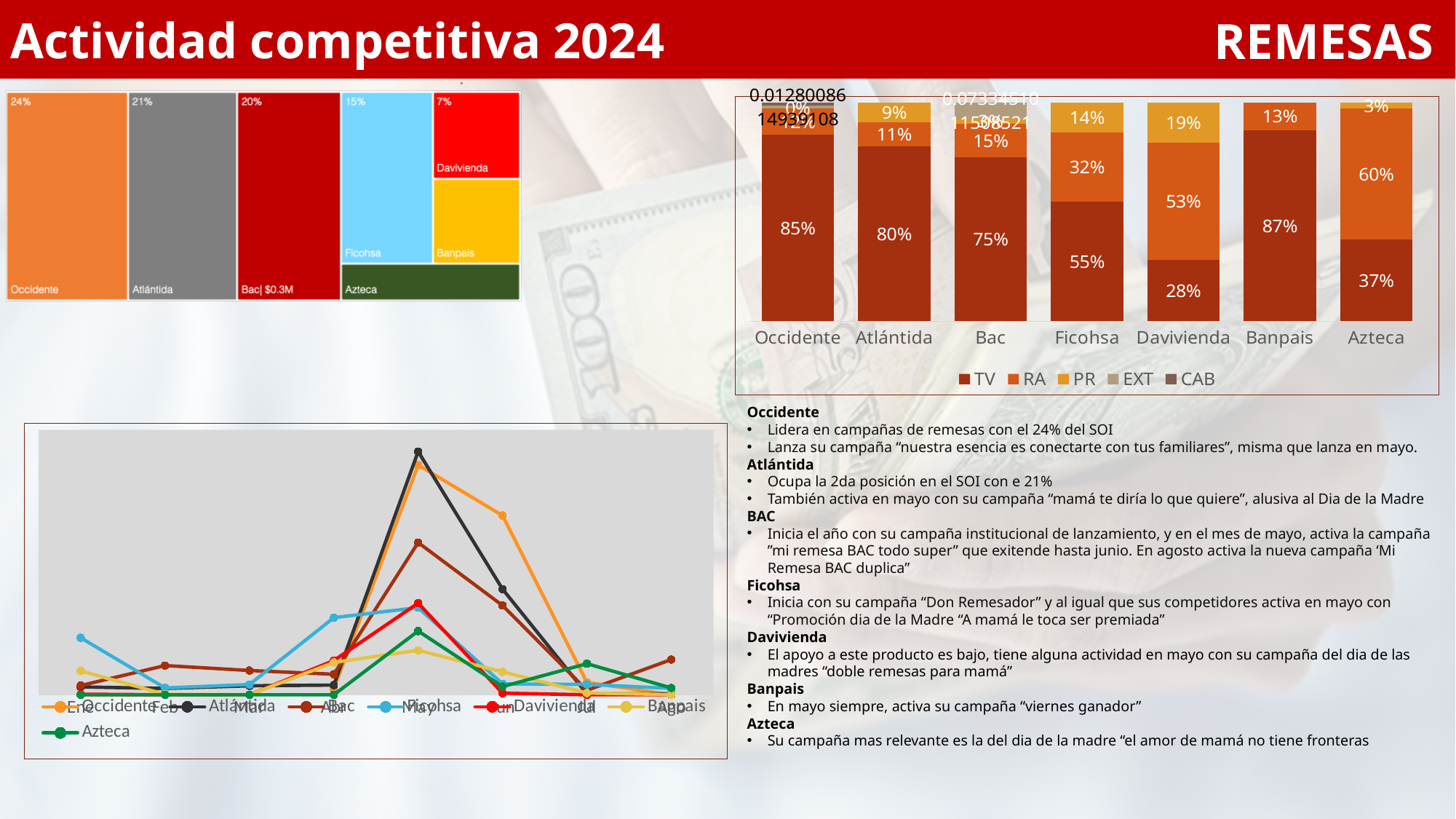
In the treemap chart at the top left, which company has the largest share? Occidente In the stacked bar chart at the top right, how many companies are shown on the x axis? 7 What kind of chart is shown at the bottom left of the slide? Line chart In the stacked bar chart at the top right, is the TV value for Ficohsa larger or the TV value for Bac? Bac In the treemap chart at the top left, what is the difference between the shares of Atlántida and Davivienda? 14% In the treemap chart at the top left, what share is shown for Occidente? 24% In the line chart at the bottom left, in which month does Atlántida reach its peak? May In the stacked bar chart at the top right, what is the TV value for Banpais? 87% In the stacked bar chart at the top right, what is the RA value for Azteca? 60% In the stacked bar chart at the top right, how many series does the legend list? 5 In the stacked bar chart at the top right, which company has the lowest TV value? Davivienda In the stacked bar chart at the top right, what is the PR value for Davivienda? 19%